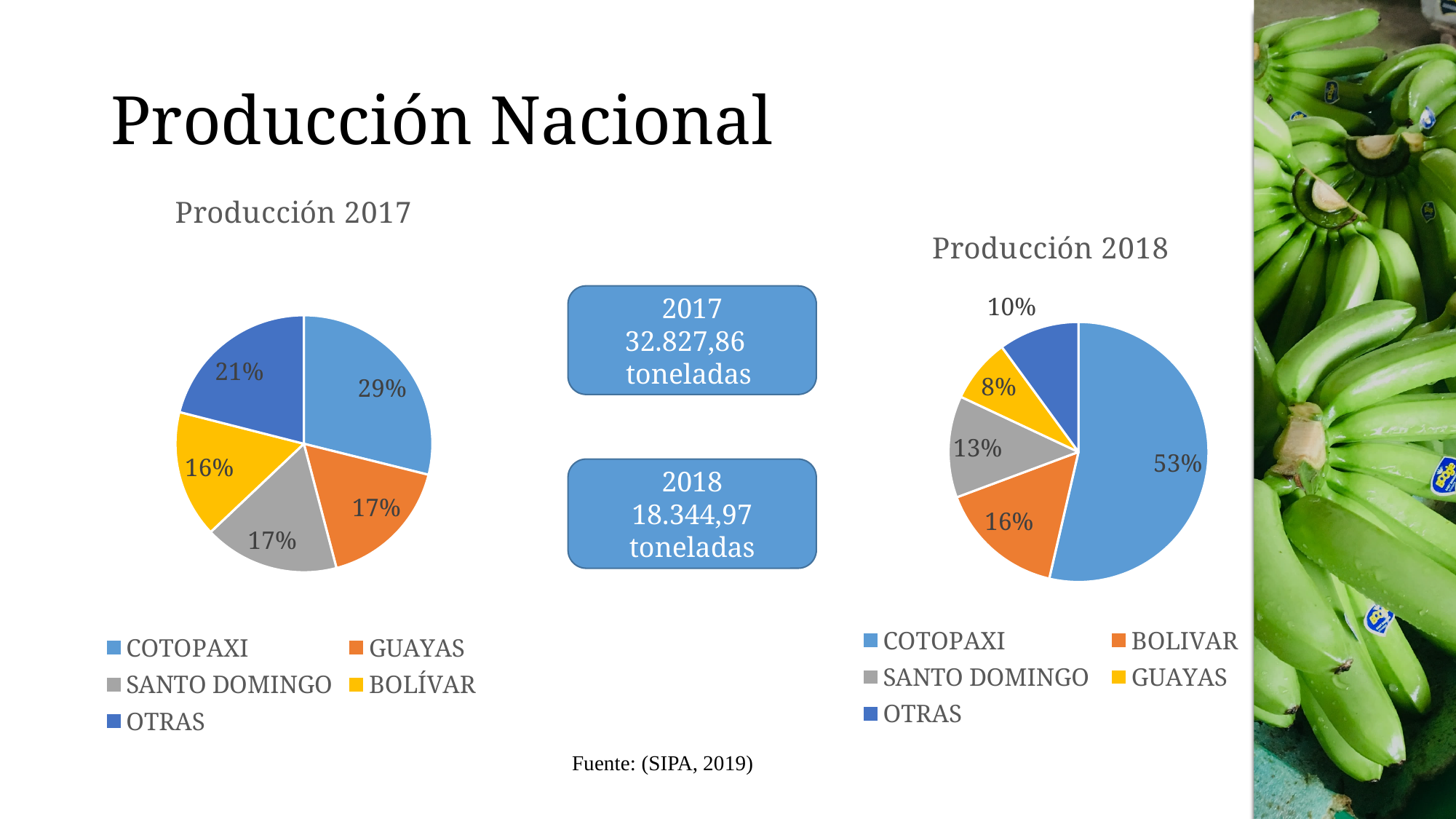
What type of chart is the Producción 2017 chart? Pie chart In the Producción 2018 chart, what share does COTOPAXI have? 53% In the Producción 2017 chart, which category has the smallest share? BOLÍVAR In the Producción 2017 chart, what share does COTOPAXI have? 29% In the Producción 2017 chart, what share does OTRAS have? 21% In the Producción 2017 chart, what share does BOLÍVAR have? 16% In the Producción 2018 chart, which category has the smallest share? GUAYAS How many categories does the Producción 2018 chart's legend list? 5 In the Producción 2018 chart, what share does SANTO DOMINGO have? 13% What is the difference in percentage points between COTOPAXI's share in the Producción 2018 chart and its share in the Producción 2017 chart? 24 In the Producción 2018 chart, which category has the largest share? COTOPAXI In the Producción 2018 chart, what share does GUAYAS have? 8%